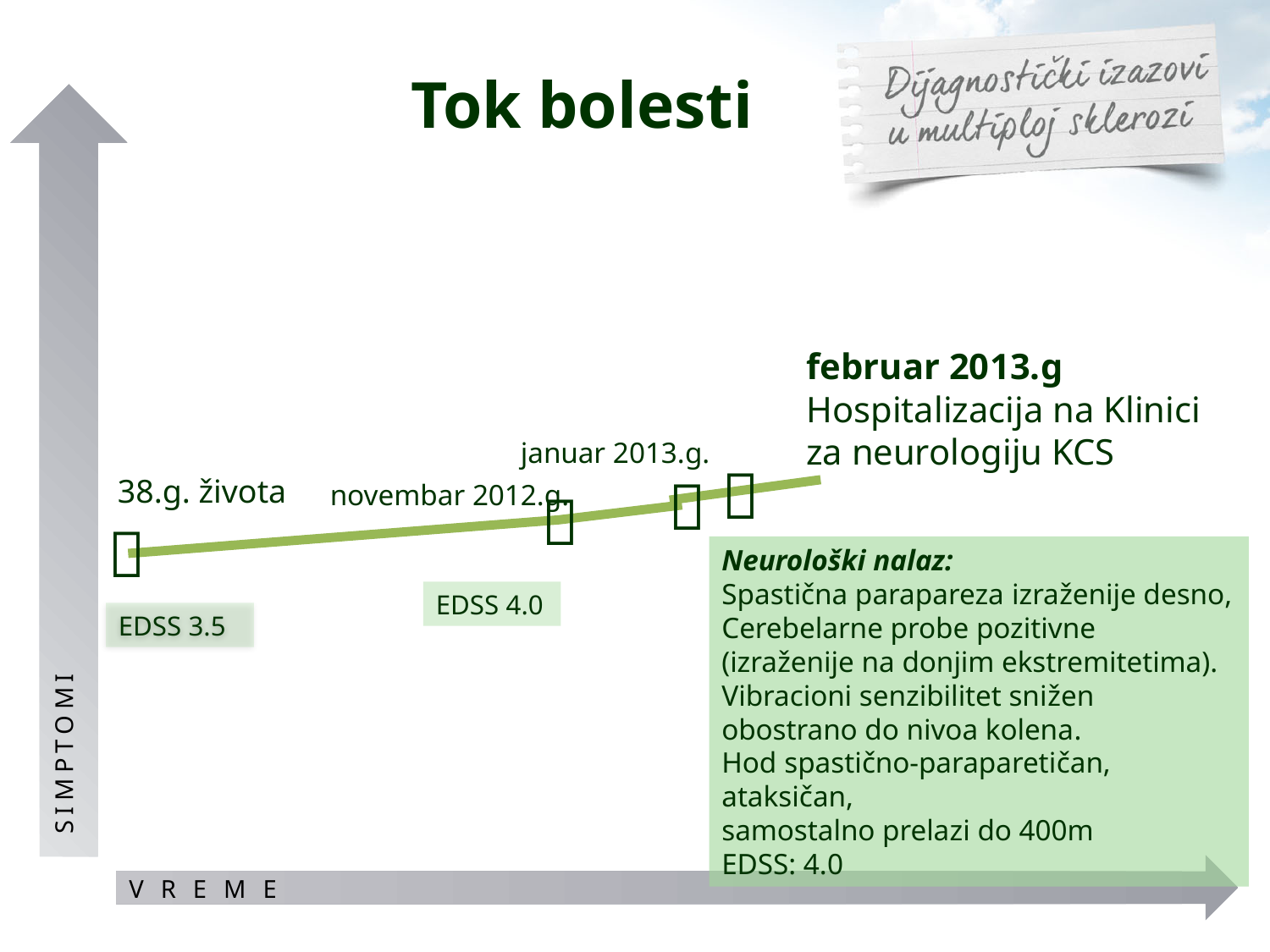
Does the green line rise or fall along the time axis? rises Which point has the higher EDSS value, "38.g. života" or "novembar 2012.g."? novembar 2012.g. What EDSS value is shown at the point labelled "38.g. života"? EDSS 3.5 What EDSS value is shown at the point labelled "novembar 2012.g."? EDSS 4.0 What is the label of the vertical axis? SIMPTOMI What EDSS value is given in the neurological finding box for februar 2013? EDSS: 4.0 What is the difference between the EDSS value at novembar 2012.g. and the EDSS value at 38.g. života? 0.5 What kind of chart is shown on the slide? line chart How many marked time points are shown along the line? 4 What is the label of the horizontal axis? VREME